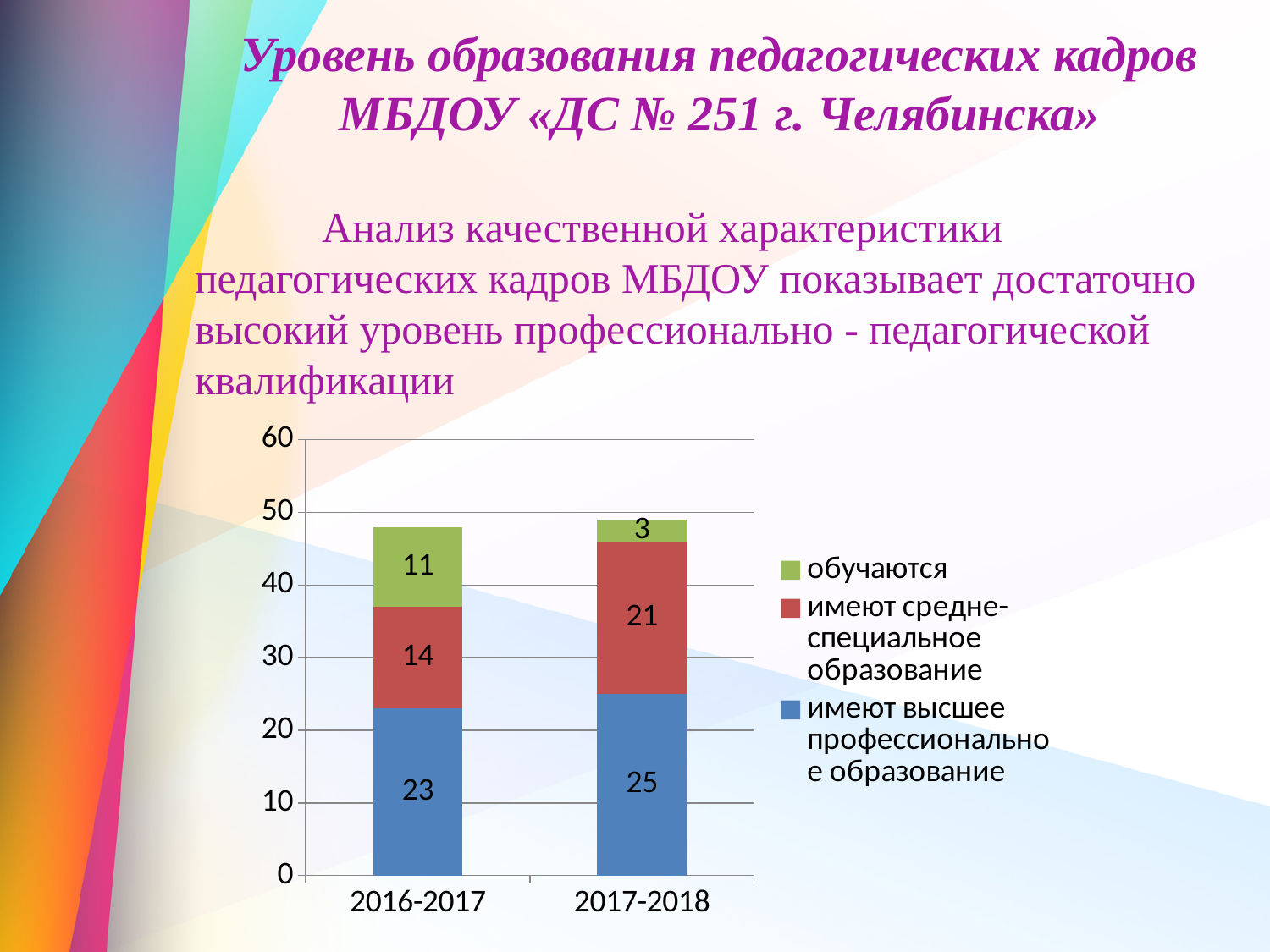
How many categories are shown on the x axis? 2 How many series does the legend list? 3 Which year has the larger value for "обучаются", 2016-2017 or 2017-2018? 2016-2017 What is the difference between the "имеют средне-специальное образование" values for 2017-2018 and 2016-2017? 7 What is the total of the stacked bar for 2016-2017? 48 What is the value for "обучаются" in 2017-2018? 3 Which colour represents the series "обучаются" in the chart? green What is the total of the stacked bar for 2017-2018? 49 What is the value for "обучаются" in 2016-2017? 11 What kind of chart is shown on the slide? stacked bar chart What is the value for "имеют высшее профессиональное образование" in 2016-2017? 23 What is the value for "имеют средне-специальное образование" in 2017-2018? 21